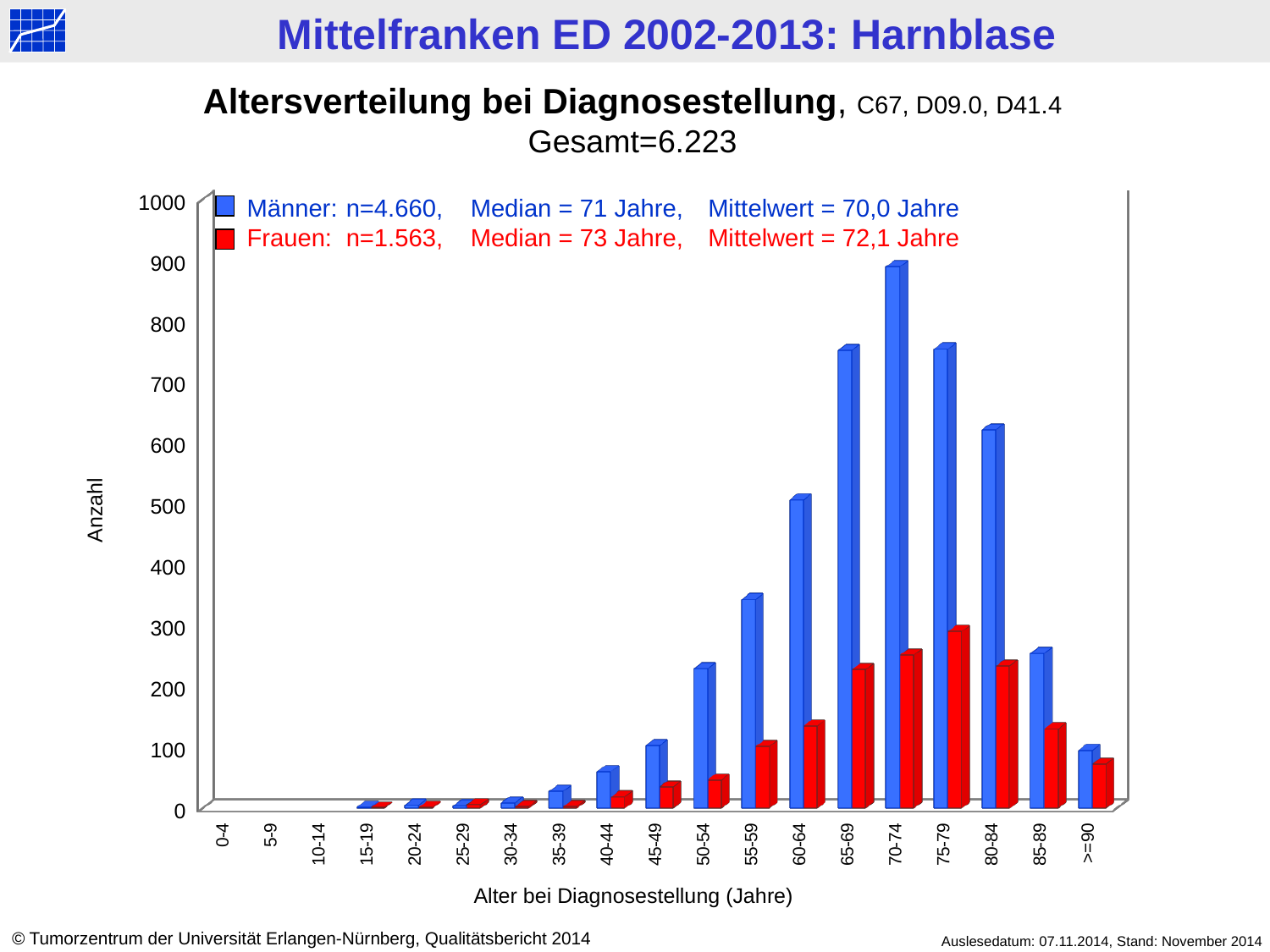
Is the value for Männer in the 55-59 age group greater or less than 400? less Which age group has the highest value for Männer? 70-74 How many series does the legend list? 2 Is the value for Frauen in the 75-79 age group greater or less than 200? greater According to the legend, what is the n for Männer? n=4.660 Is the value for Männer in the 70-74 age group greater or less than 800? greater What kind of chart is shown on the slide? bar chart Which age group has the highest value for Frauen? 75-79 How many age categories are shown on the x axis? 19 In the 70-74 age group, which series has the larger value, Männer or Frauen? Männer For Männer, do the values rise or fall from the 70-74 age group to the >=90 age group? fall